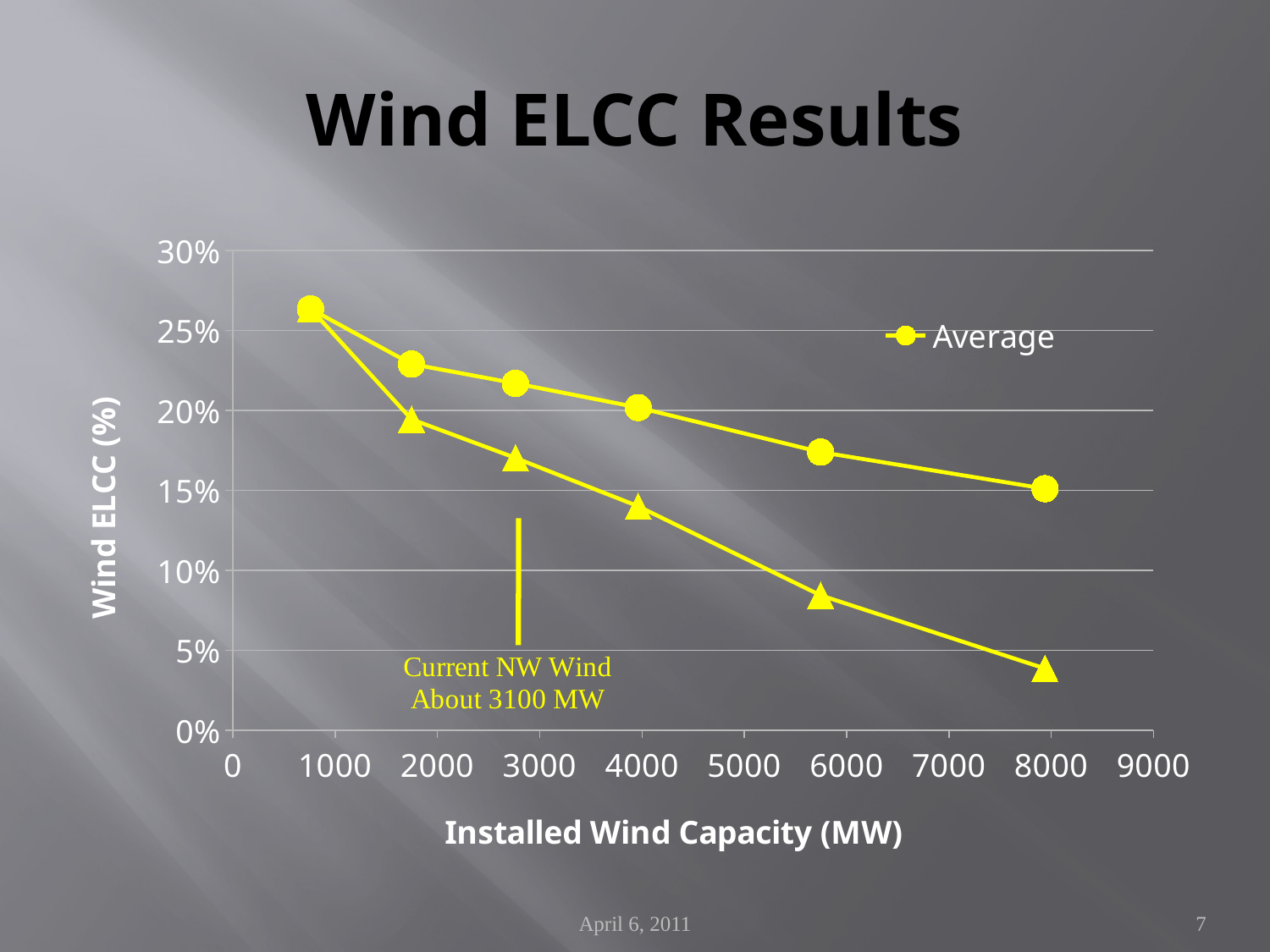
How many data points are plotted on the Average line? 6 Is the value of the line with triangle markers at roughly 8000 MW greater or less than 5%? less Is the Average value at roughly 2000 MW greater or less than 25%? less What is the title of the chart? Wind ELCC Results At roughly 8000 MW, which line is higher: the Average line (circle markers) or the line with triangle markers? Average Is the Average value at roughly 6000 MW greater or less than 20%? less How many series does the legend list? 1 Does the Average line rise or fall as installed wind capacity increases? fall What is the label of the x axis? Installed Wind Capacity (MW) What kind of chart is shown on the slide? line chart